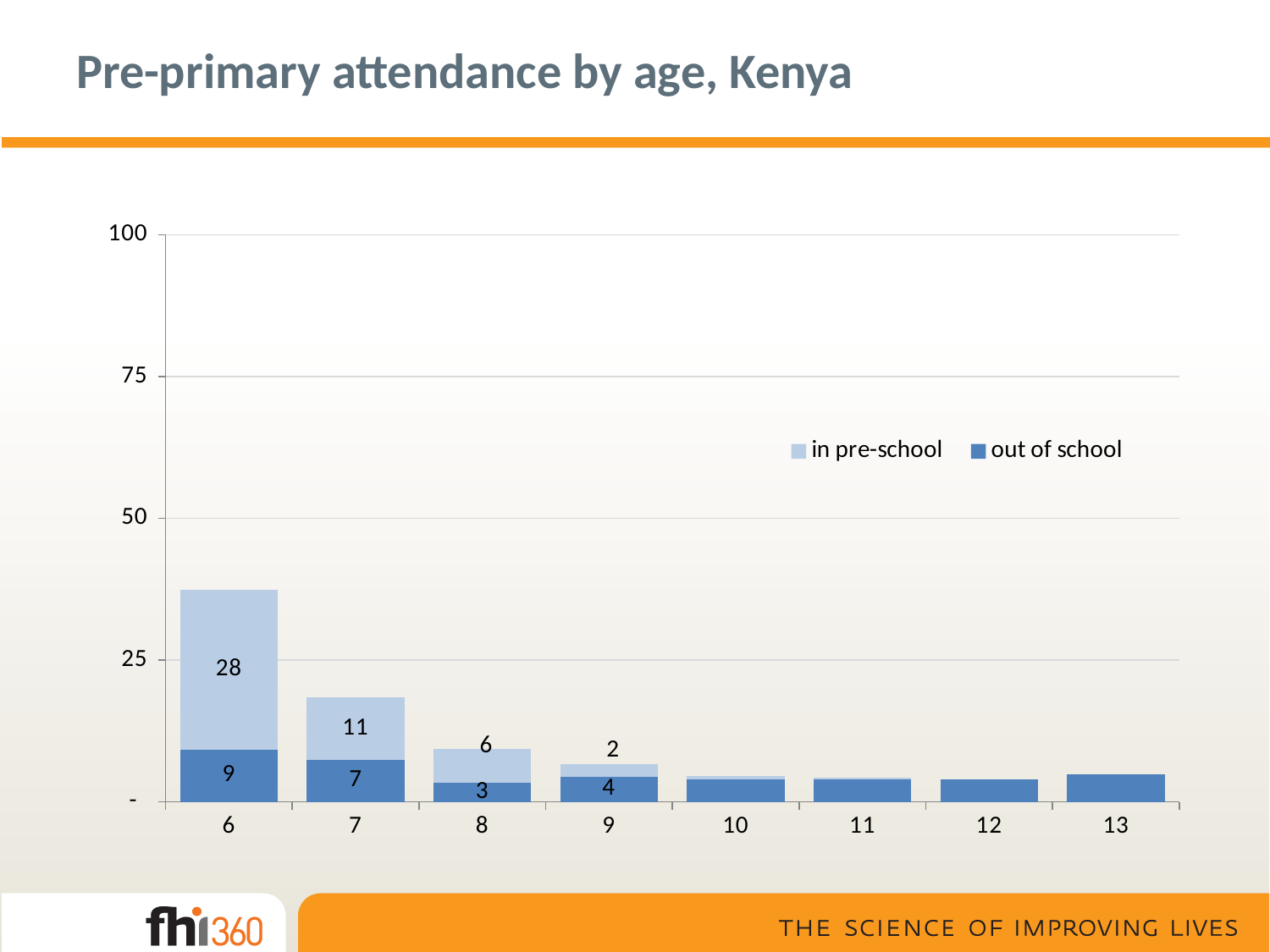
What is the total height of the stacked bar for age 7? 18 At age 6, how much larger is the 'in pre-school' value than the 'out of school' value? 19 What is the value for 'in pre-school' at age 8? 6 What is the value for 'out of school' at age 9? 4 How many series does the legend list? 2 What is the value for 'out of school' at age 7? 7 How many age categories are shown on the x axis? 8 What kind of chart is shown on the slide? stacked bar chart What is the total height of the stacked bar for age 6? 37 What is the value for 'in pre-school' at age 6? 28 Which age has the highest 'in pre-school' value? 6 Do the 'in pre-school' values rise or fall as age increases from 6 to 9? fall